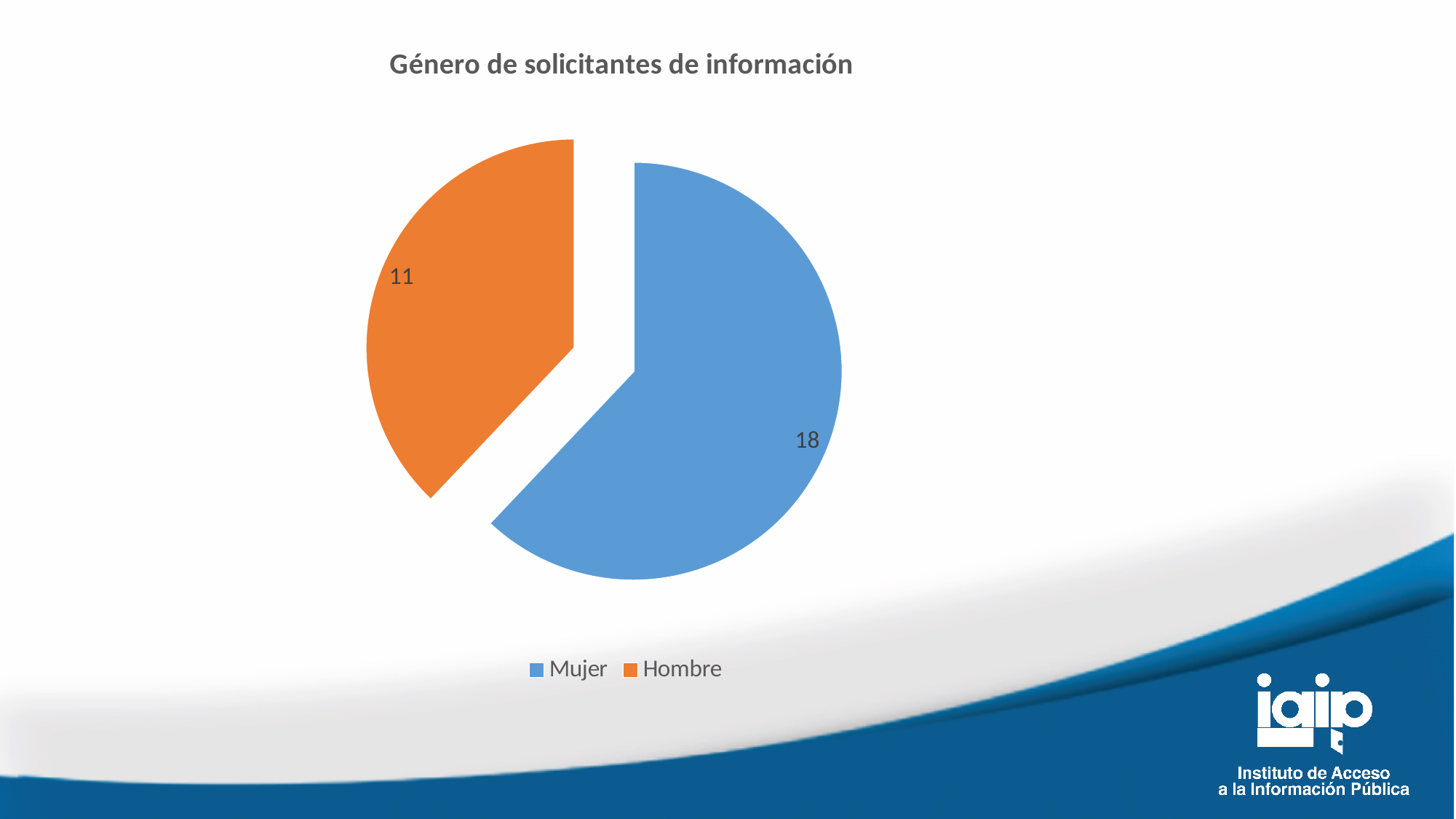
What kind of chart is shown on the slide? Pie chart What is the value for Hombre? 11 Which category has the largest slice? Mujer What is the title of the chart? Género de solicitantes de información What colour is the Hombre slice? Orange How many categories does the pie chart show? 2 Which is larger, the value for Mujer or the value for Hombre? Mujer What is the value for Mujer? 18 What is the difference between the values for Mujer and Hombre? 7 What is the total of all slices in the pie chart? 29 Which category has the smallest slice? Hombre